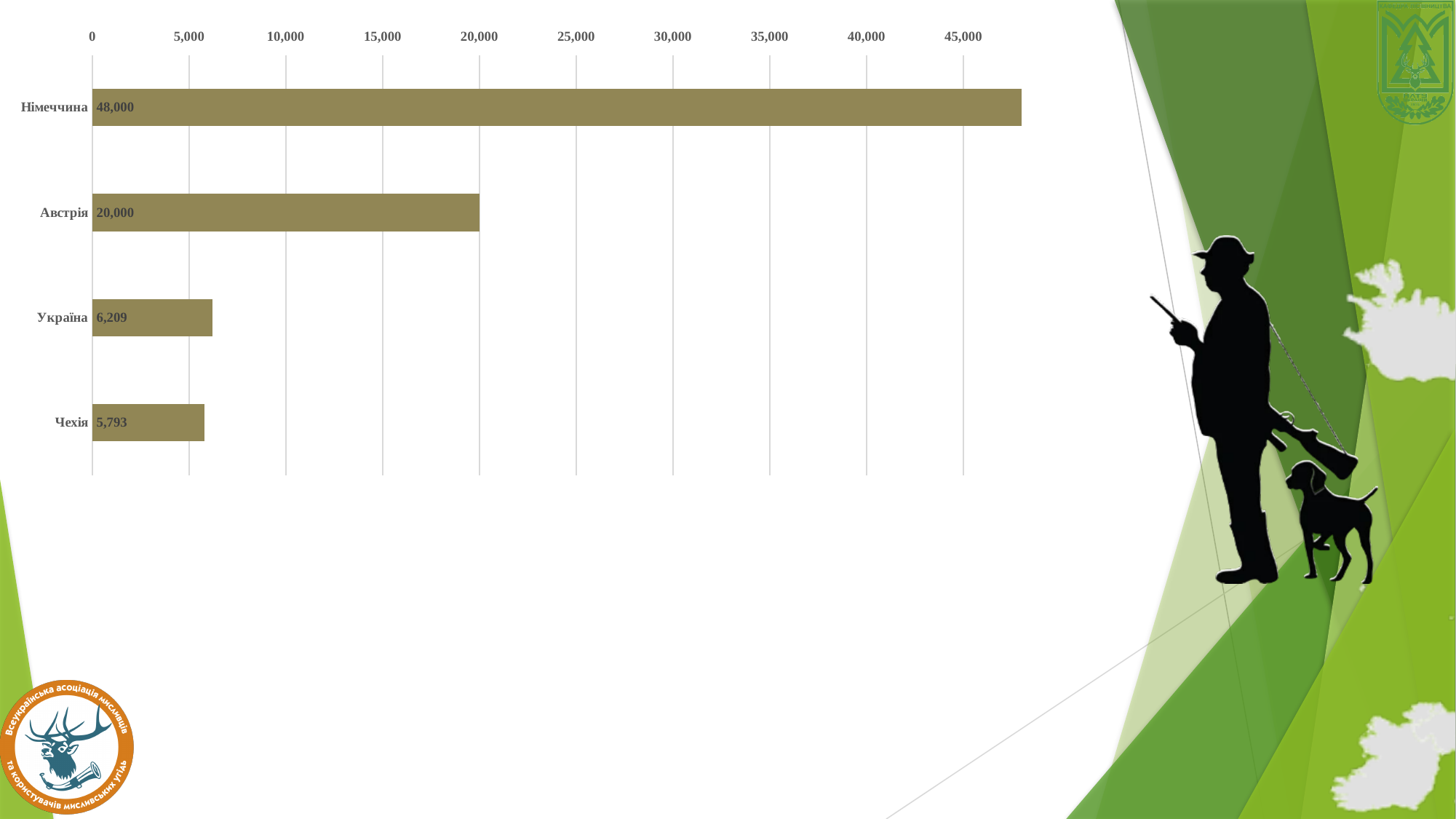
Is the value for Австрія greater or less than 15,000? greater How many categories are shown in the chart? 4 What kind of chart is shown on the slide? bar chart What is the value for Україна? 6,209 Which is larger, the value for Австрія or the value for Україна? Австрія What is the difference between the values for Німеччина and Австрія? 28,000 Which category has the highest value? Німеччина Which category has the lowest value? Чехія What is the value for Німеччина? 48,000 What is the value for Чехія? 5,793 What is the difference between the values for Україна and Чехія? 416 What is the value for Австрія? 20,000